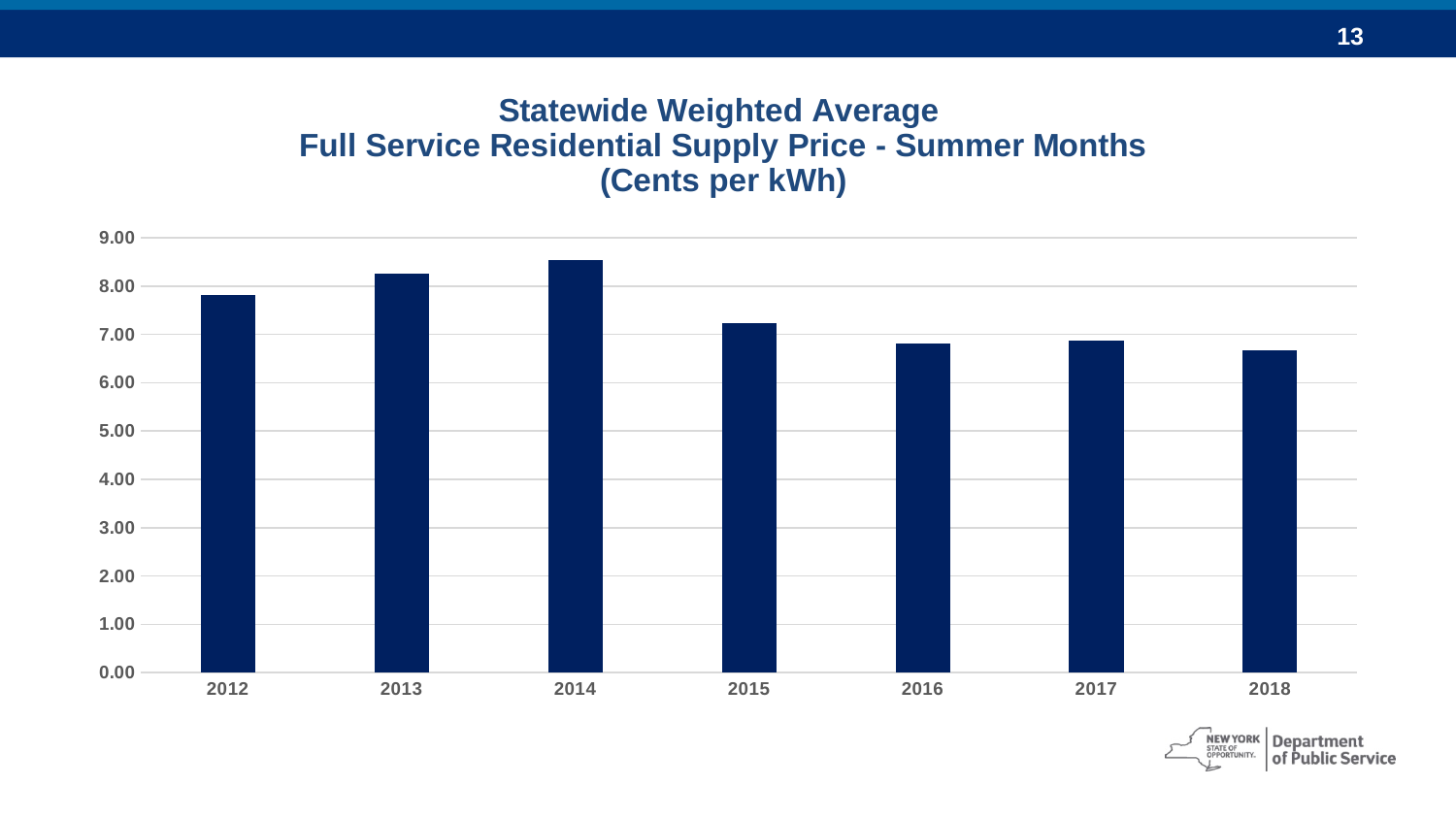
Is the value for 2014 greater or less than 8.00? greater Is the value for 2012 greater or less than 7.00? greater What kind of chart is shown on the slide? bar chart Is the value for 2016 greater or less than 7.00? less How many years are shown on the x axis of the chart? 7 Which year has the highest statewide weighted average supply price? 2014 Which is larger, the value for 2013 or the value for 2016? 2013 Do the values rise or fall from 2014 to 2018? fall In what units are the values on the chart expressed, according to the title? Cents per kWh Which is larger, the value for 2012 or the value for 2015? 2012